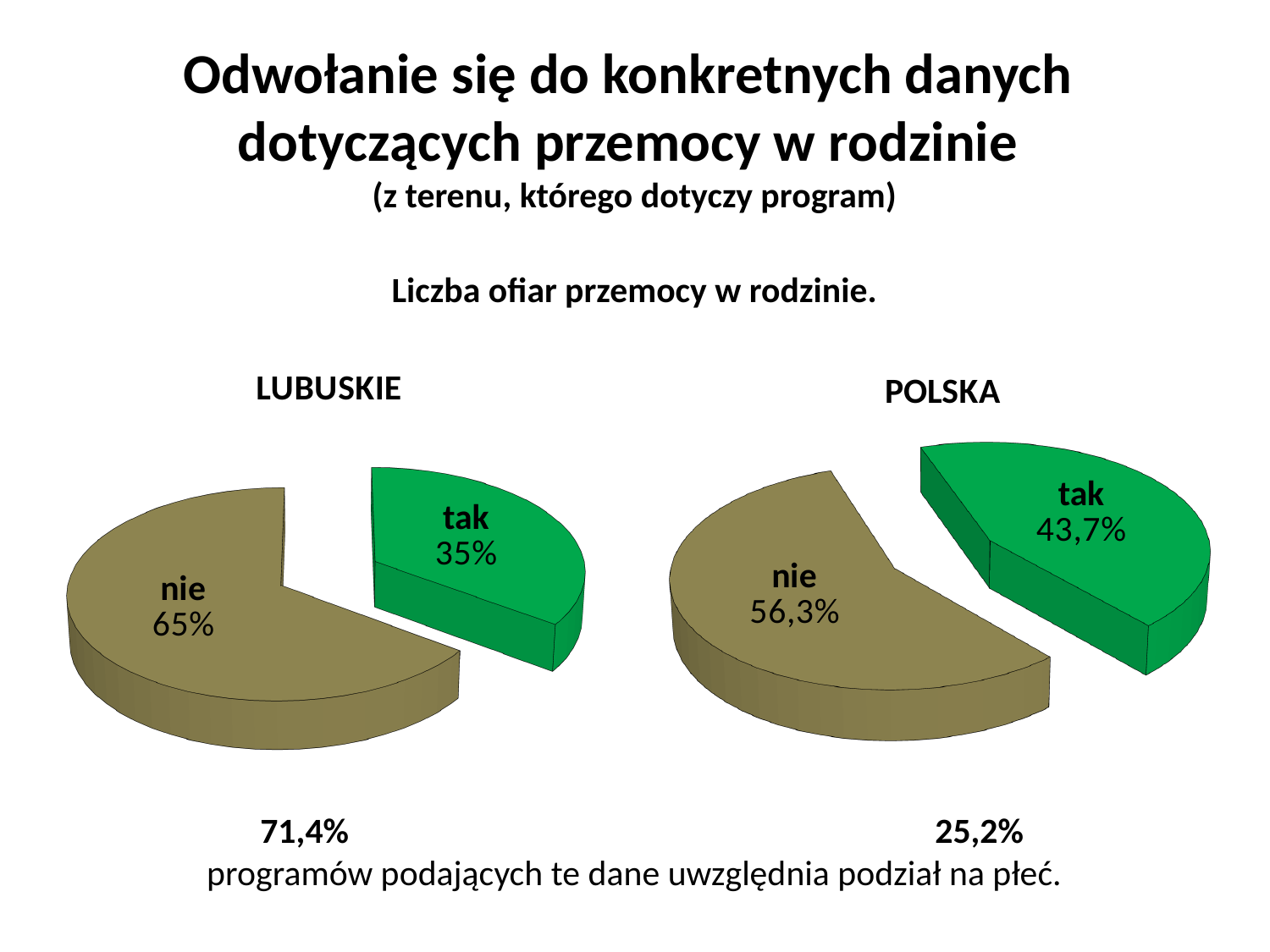
In the POLSKA pie chart, what is the difference between the "nie" and "tak" slices? 12,6% In the POLSKA pie chart, what is the value for "tak"? 43,7% In the LUBUSKIE pie chart, what is the value for "tak"? 35% In the LUBUSKIE pie chart, what is the value for "nie"? 65% How many slices does the LUBUSKIE pie chart have? 2 What colour is the "tak" slice in the LUBUSKIE pie chart? Green In the LUBUSKIE pie chart, which slice is the largest? nie In the POLSKA pie chart, which slice is the smallest? tak In the LUBUSKIE pie chart, what is the difference between the "nie" and "tak" slices? 30% In the POLSKA pie chart, what is the value for "nie"? 56,3% What type of chart is used for POLSKA? Pie chart Which chart has the larger "tak" share, LUBUSKIE or POLSKA? POLSKA